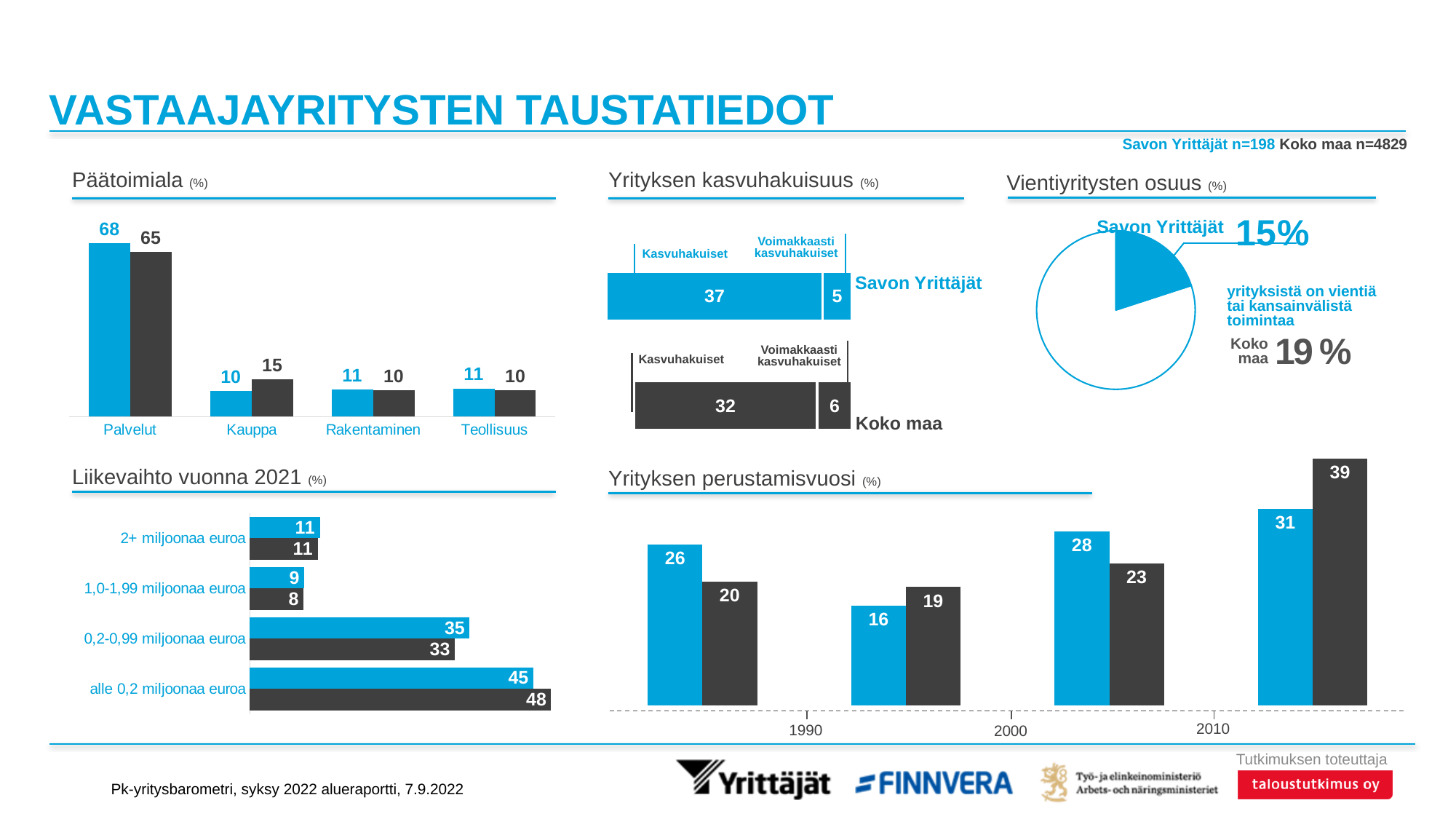
In the "Yrityksen perustamisvuosi" chart, what is the difference between the Koko maa value (39) and the Savon Yrittäjät value (31) for the rightmost period? 8 How many categories are shown in the "Päätoimiala" chart? 4 In the "Päätoimiala" chart, which category has the highest value for Koko maa (dark bar)? Palvelut In the "Liikevaihto vuonna 2021" chart, which category has the lowest Koko maa value? 1,0-1,99 miljoonaa euroa In the "Yrityksen kasvuhakuisuus" chart, what is the Voimakkaasti kasvuhakuiset value for Koko maa? 6 In the "Vientiyritysten osuus" pie chart, what share of Savon Yrittäjät companies have export or international activity? 15% In the "Liikevaihto vuonna 2021" chart, what is the Koko maa value for "alle 0,2 miljoonaa euroa"? 48 In the "Yrityksen kasvuhakuisuus" chart, what is the total of the Savon Yrittäjät stacked bar (Kasvuhakuiset plus Voimakkaasti kasvuhakuiset)? 42 In the "Päätoimiala" chart, what is the value for Palvelut for Savon Yrittäjät (blue bar)? 68 What kind of chart is "Liikevaihto vuonna 2021"? Bar chart In the "Yrityksen perustamisvuosi" chart, which is larger for the last (rightmost) period: Savon Yrittäjät or Koko maa? Koko maa In the "Päätoimiala" chart, what is the difference between the Koko maa and Savon Yrittäjät values for Kauppa? 5